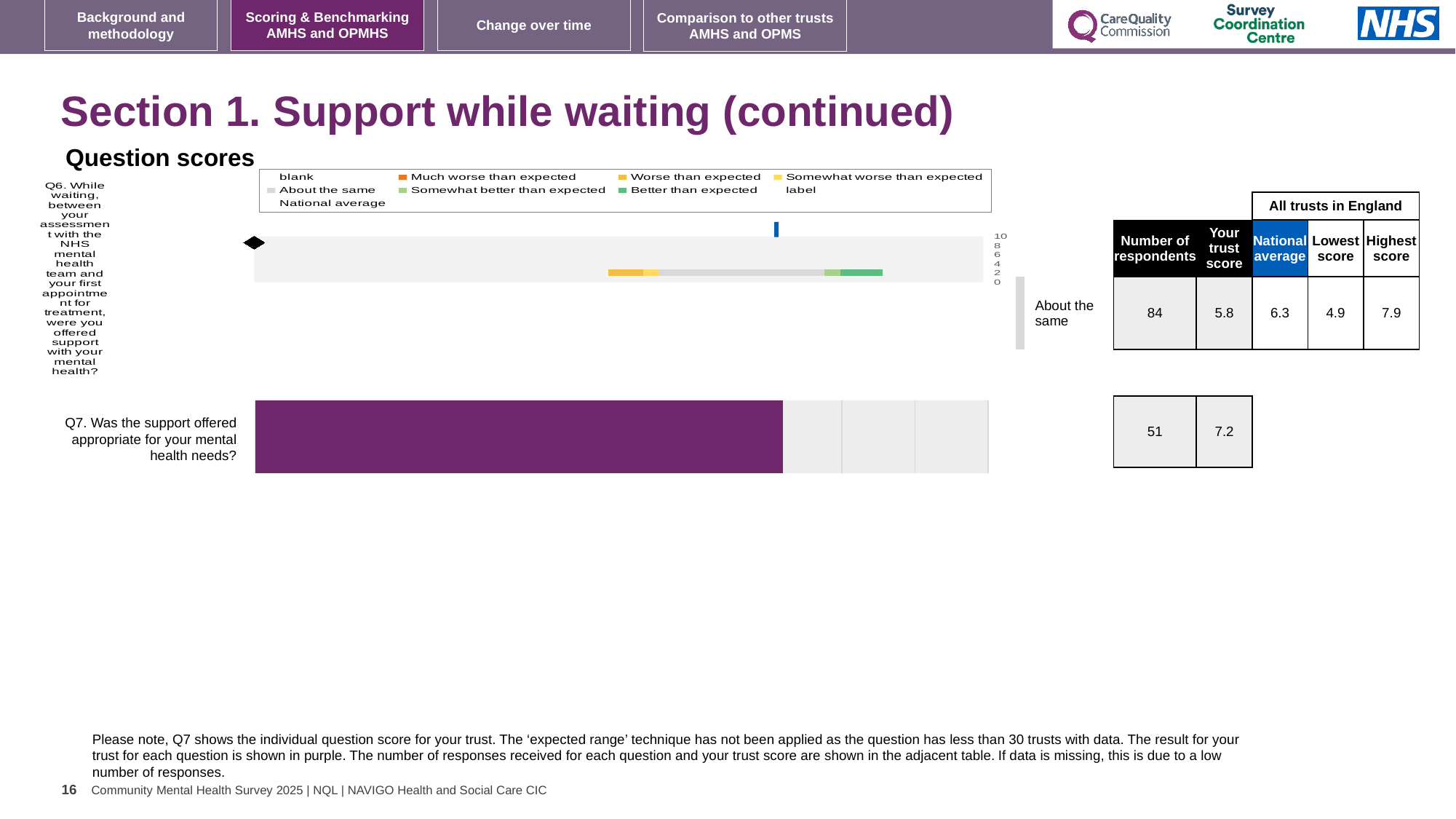
What is the national average score for Q6? 6.3 For Q6, which is larger: the trust score or the national average? National average What is the lowest score among all trusts in England for Q6? 4.9 How many respondents answered Q6? 84 What is the trust score for Q7? 7.2 Which expected-range category is the trust's Q6 score placed in? About the same Is the purple bar for Q7 greater or less than 6 on the score axis? greater What is the highest score among all trusts in England for Q6? 7.9 What is the trust score for Q6 (support while waiting between assessment and first appointment)? 5.8 What is the difference between the highest and lowest scores for Q6 across all trusts in England? 3.0 How many respondents answered Q7 (was the support offered appropriate for your mental health needs)? 51 How many more respondents answered Q6 than Q7? 33